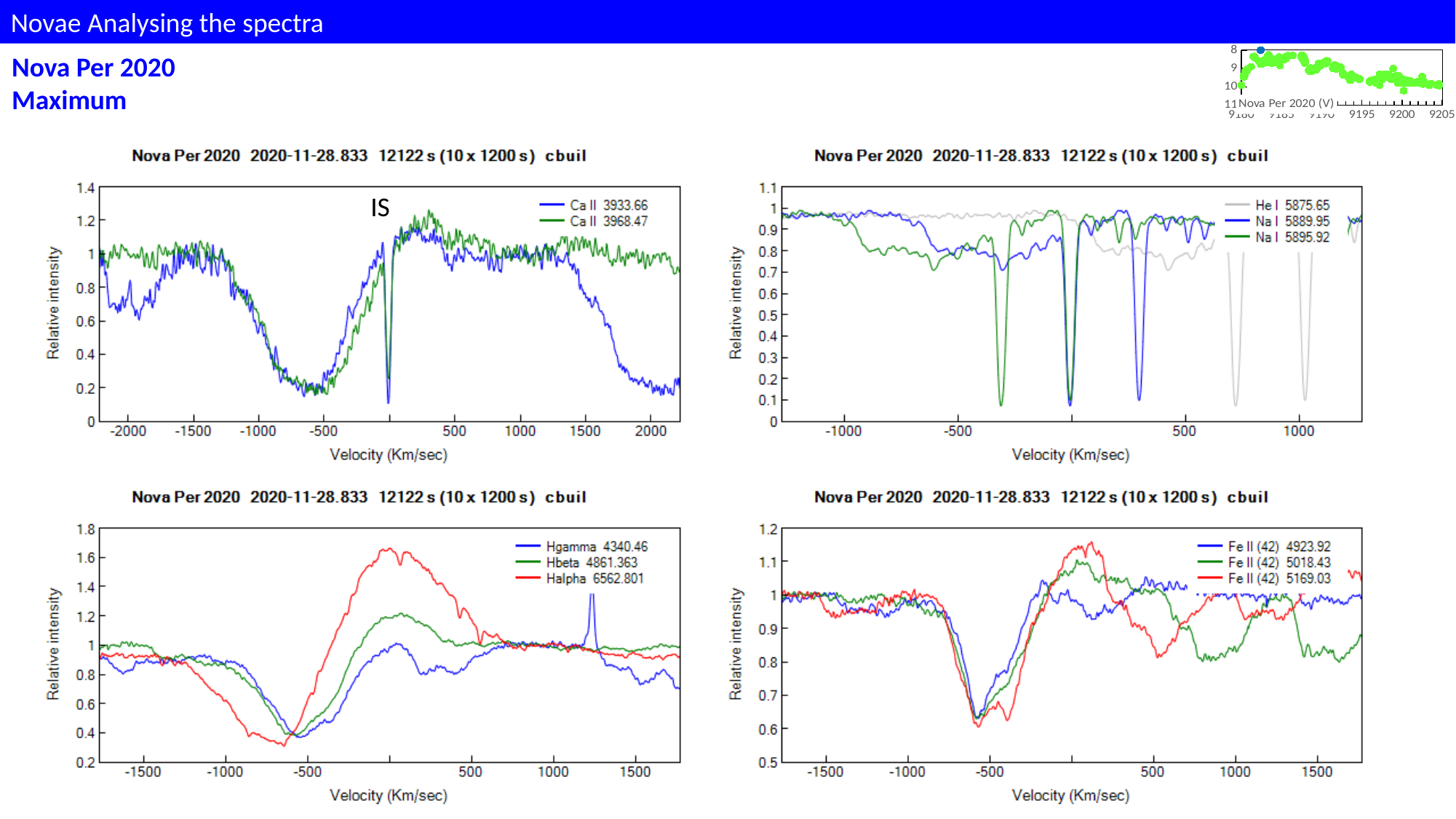
What is the x-axis label of the bottom-left chart (Balmer lines)? Velocity (Km/sec) How many series does the legend of the bottom-left chart (Balmer lines) list? 3 In the bottom-right chart, is the minimum relative intensity of the Fe II lines near -550 km/sec greater or less than 0.7? less How many series does the legend of the top-left chart (Ca II) list? 2 In the top-left chart, which series has the lower relative intensity at +2000 km/sec, Ca II 3933.66 or Ca II 3968.47? Ca II 3933.66 In the bottom-left chart, what colour is the Halpha 6562.801 series? red How many series does the legend of the bottom-right chart (Fe II lines) list? 3 In the bottom-left chart, is the peak relative intensity of Halpha 6562.801 greater or less than 1.4? greater What kind of chart is the top-left chart (Ca II lines)? line chart In the bottom-left chart, which series reaches the highest relative intensity? Halpha 6562.801 In the top-right chart, is the minimum relative intensity of the Na I 5895.92 absorption near -350 km/sec greater or less than 0.2? less